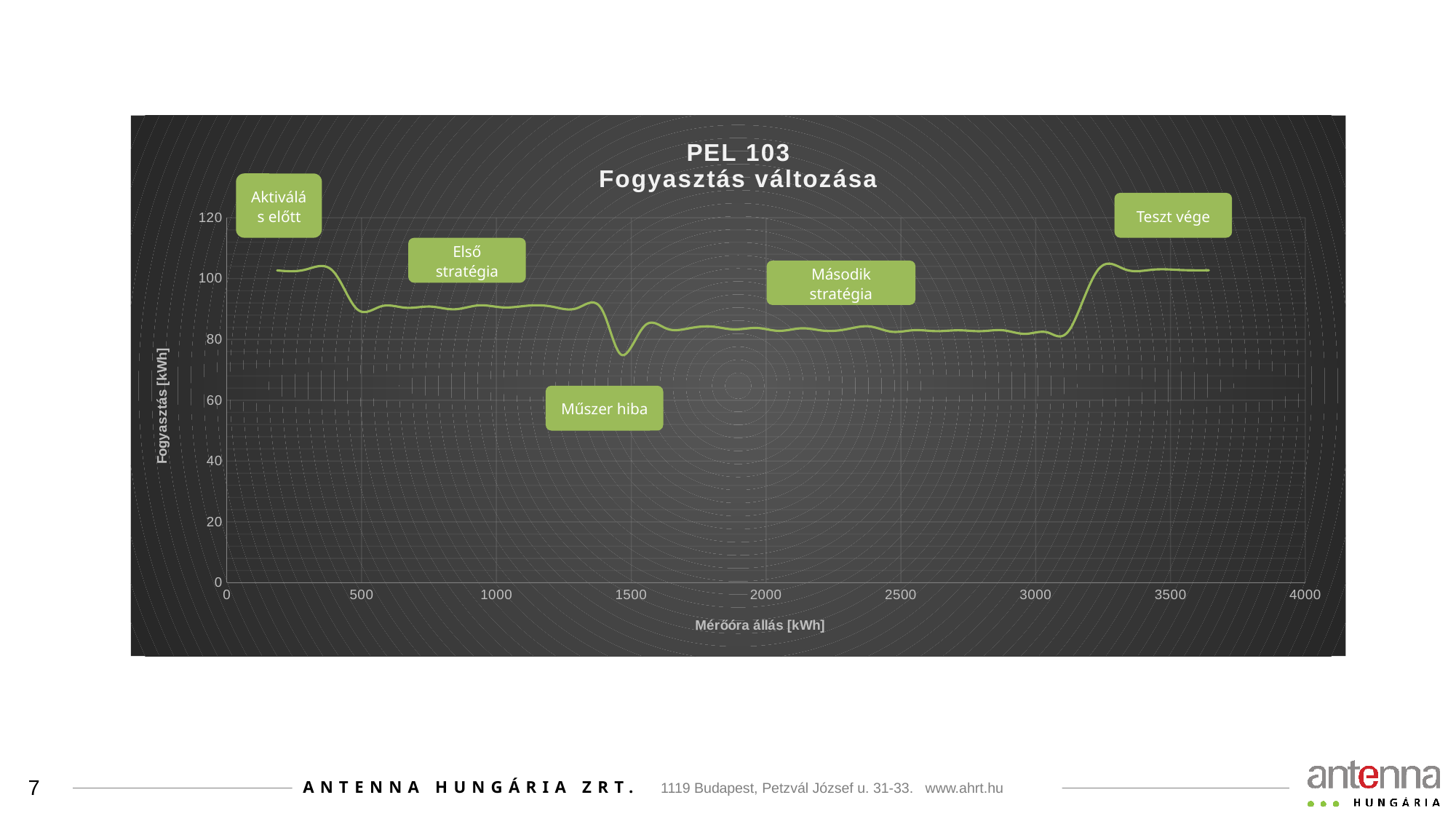
Is the value at a meter reading of 1000 kWh greater or less than 100? less Is the value at a meter reading of 200 kWh greater or less than 80? greater What kind of chart is shown on the slide? line chart Is the value at a meter reading of 1000 kWh greater or less than 80? greater What is the title of the chart? PEL 103 Fogyasztás változása Which is larger: the value at a meter reading of 500 kWh or the value at 2500 kWh? 500 kWh Does the line rise or fall between meter readings of 3000 and 3500 kWh? rise What is the label of the vertical axis? Fogyasztás [kWh] Does the line rise or fall between meter readings of 200 and 1000 kWh? fall